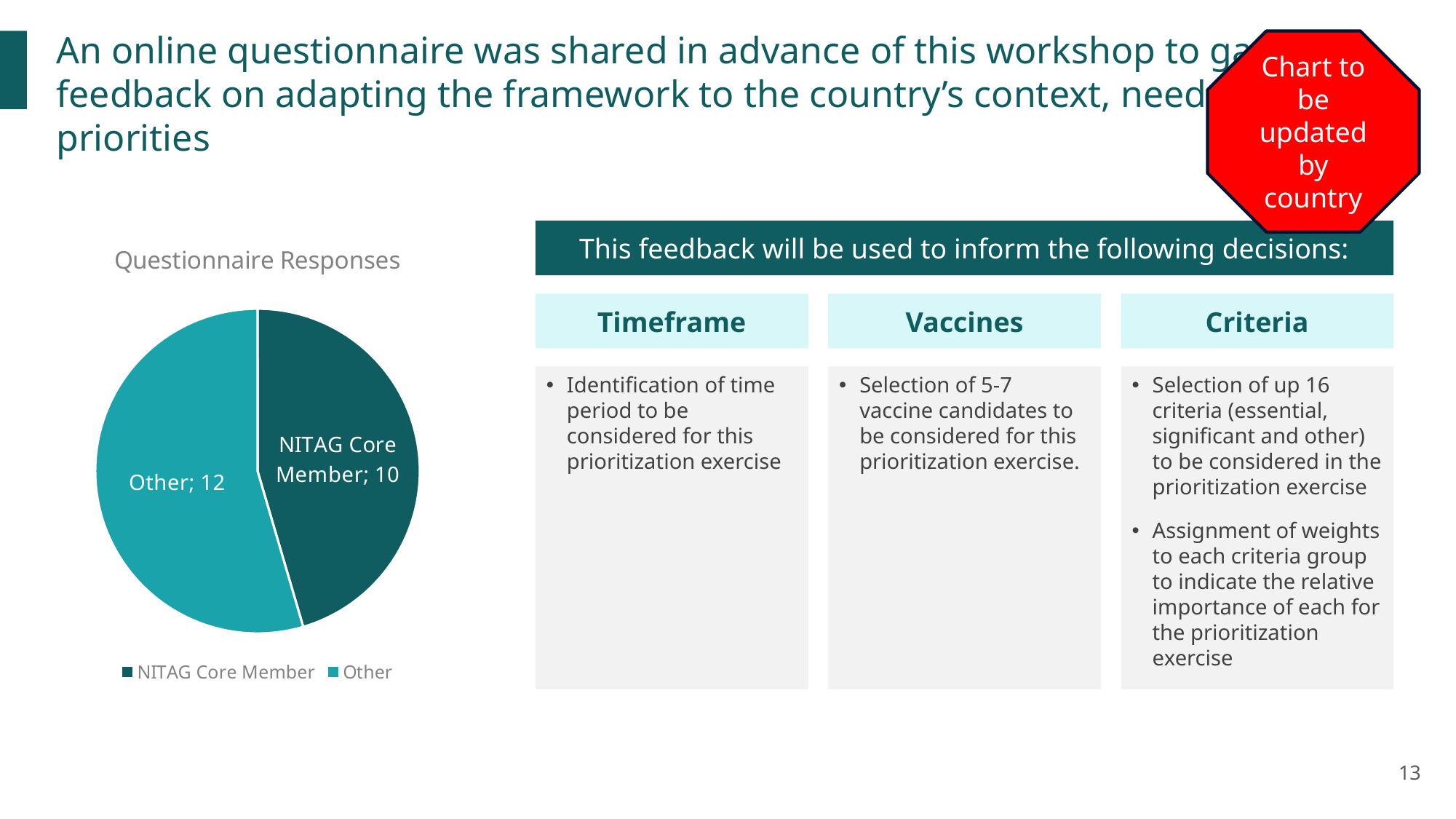
What is the difference between the Other and NITAG Core Member response counts? 2 What is the title of the chart? Questionnaire Responses How many responses are from NITAG Core Members? 10 How many entries does the legend list? 2 Which category has the larger number of responses? Other Which legend entry is shown in the darker teal colour? NITAG Core Member Which category has the smaller number of responses? NITAG Core Member How many responses are in the Other category? 12 What kind of chart is shown on the slide? pie chart How many slices does the pie chart have? 2 Is the value for Other larger than the value for NITAG Core Member? Yes What is the total number of questionnaire responses shown in the pie chart? 22